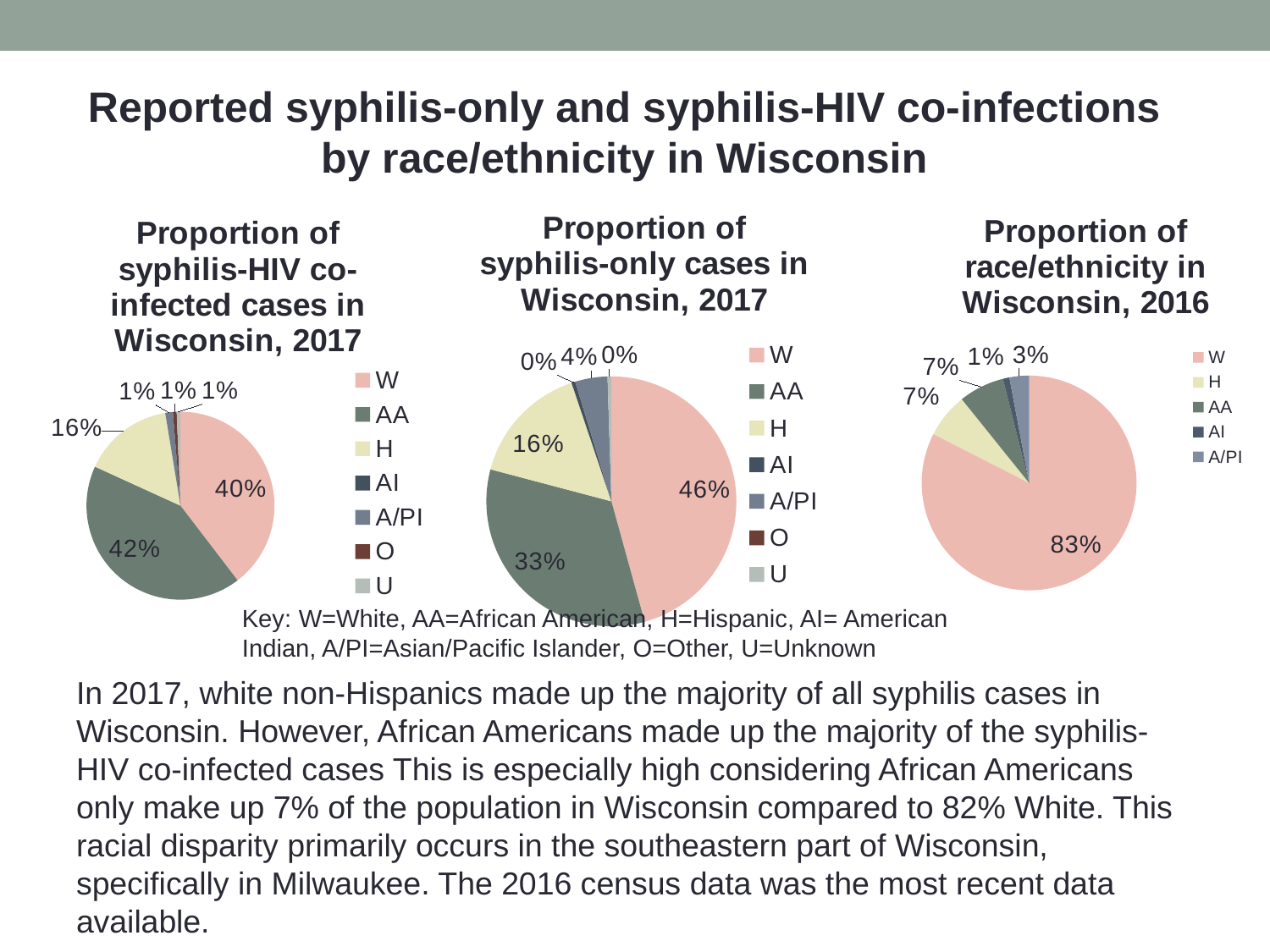
In the 'Proportion of race/ethnicity in Wisconsin, 2016' chart, how many entries does the legend list? 5 What kind of chart is the 'Proportion of race/ethnicity in Wisconsin, 2016' chart? Pie chart In the 'Proportion of syphilis-only cases in Wisconsin, 2017' chart, what share of cases is W? 46% In the 'Proportion of syphilis-HIV co-infected cases in Wisconsin, 2017' chart, how many entries does the legend list? 7 In the 'Proportion of syphilis-only cases in Wisconsin, 2017' chart, which is larger, the W slice or the AA slice? W In the 'Proportion of syphilis-HIV co-infected cases in Wisconsin, 2017' chart, which category has the largest slice? AA In the 'Proportion of syphilis-HIV co-infected cases in Wisconsin, 2017' chart, what share of cases is AA? 42% In the 'Proportion of syphilis-only cases in Wisconsin, 2017' chart, what is the difference between the W and AA shares? 13% In the 'Proportion of syphilis-only cases in Wisconsin, 2017' chart, what share of cases is AA? 33% How many charts are shown on the slide? 3 In the 'Proportion of syphilis-HIV co-infected cases in Wisconsin, 2017' chart, what share of cases is W? 40% In the 'Proportion of race/ethnicity in Wisconsin, 2016' chart, what share is W? 83%